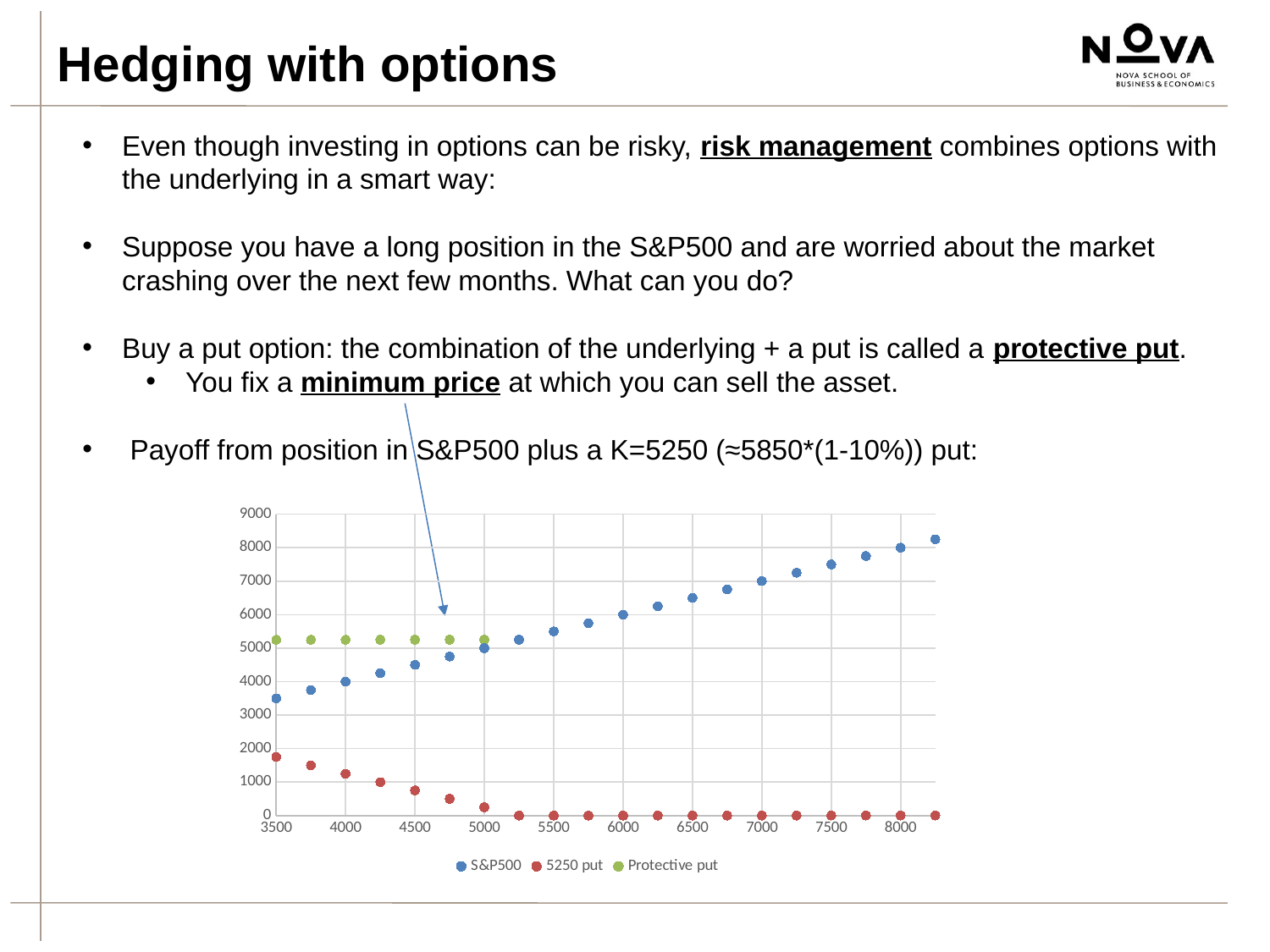
How many series does the chart legend list? 3 Is the value of the Protective put series at x = 4000 greater or less than 5000? greater What are the three series named in the chart legend? S&P500, 5250 put, Protective put At x = 4000, which series has the higher value: S&P500 or Protective put? Protective put Do the values of the S&P500 series rise or fall as the x axis increases? rise What kind of chart is shown on the slide? scatter chart Do the values of the 5250 put series rise or fall as the x axis increases? fall What is the highest value labelled on the chart's y axis? 9000 Is the value of the 5250 put series at x = 3500 greater or less than 1000? greater What is the value of the S&P500 series at an x value of 6000? 6000 Is the value of the S&P500 series at x = 3500 greater or less than 4000? less What is the value of the 5250 put series at an x value of 7000? 0